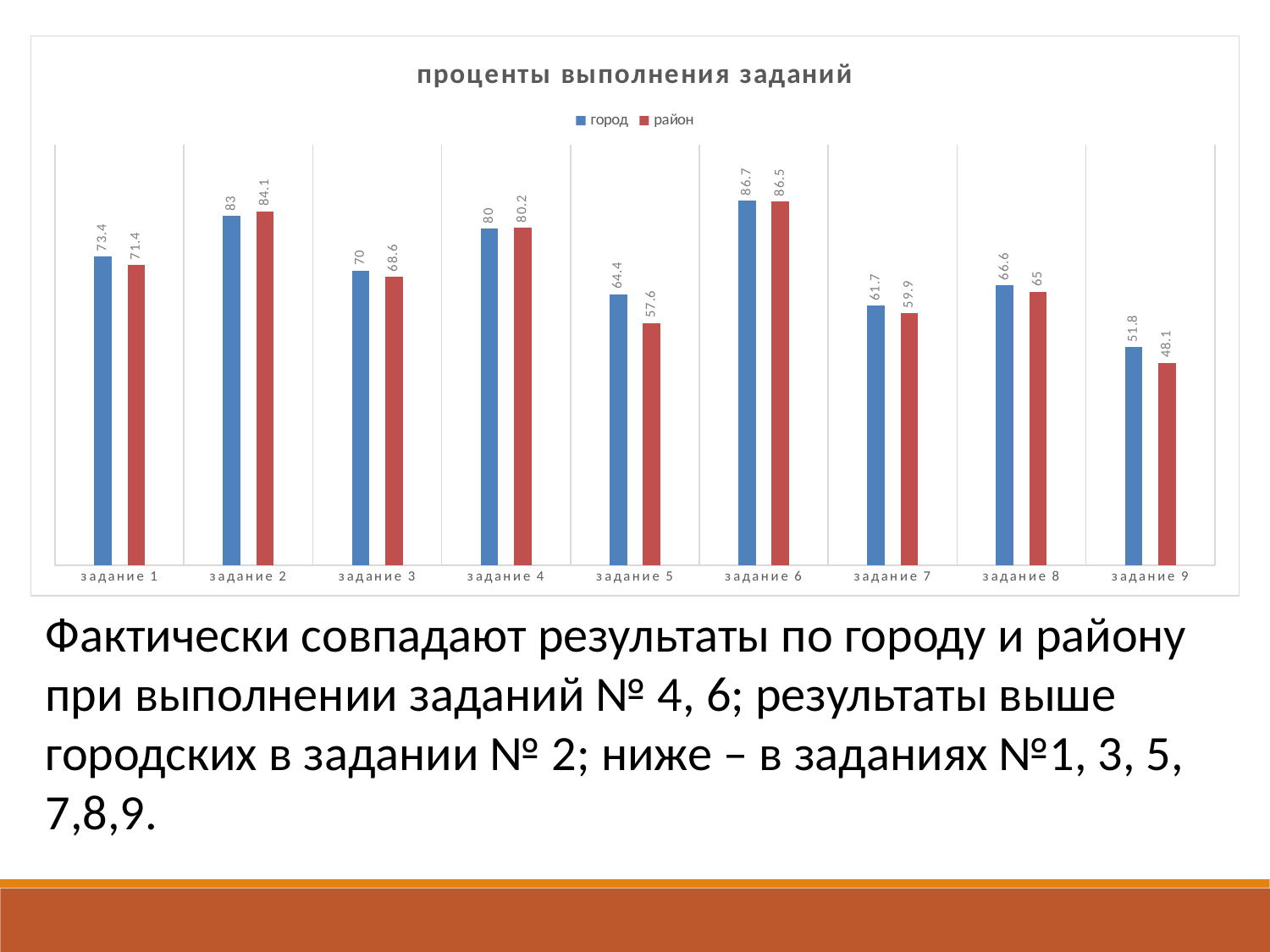
What type of chart is shown? bar chart Which task has the lowest value for район? задание 9 In задание 3, which is larger: город or район? город In задание 2, which is larger: город or район? район How many series does the legend list? 2 What is the value for район in задание 2? 84.1 Which task has the highest value for город? задание 6 What is the difference between город and район in задание 9? 3.7 What is the difference between город and район in задание 5? 6.8 How many tasks (categories) are shown on the x axis? 9 What is the value for город in задание 5? 64.4 What is the value for район in задание 9? 48.1